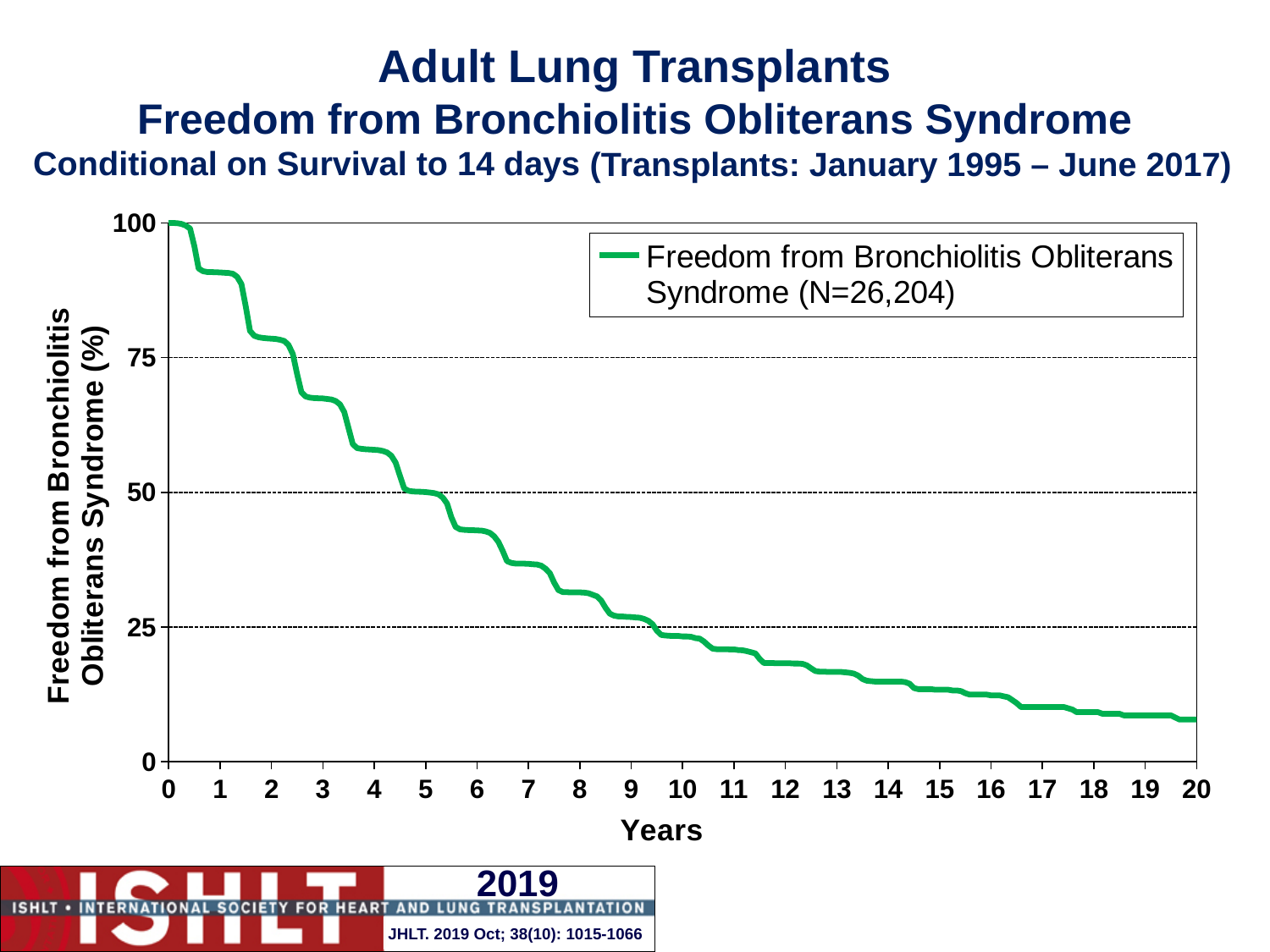
What is the value of freedom from Bronchiolitis Obliterans Syndrome at year 0? 100 Does the freedom from Bronchiolitis Obliterans Syndrome rise or fall as years increase? fall How many series does the legend list? 1 Is the value for freedom from Bronchiolitis Obliterans Syndrome at year 1 greater or less than 75? greater What is the N value given in the legend entry? N=26,204 Is the value for freedom from Bronchiolitis Obliterans Syndrome at year 3 greater or less than 50? greater What is the label of the x axis? Years Which is larger, the value at year 2 or the value at year 12? year 2 Is the value for freedom from Bronchiolitis Obliterans Syndrome at year 20 greater or less than 25? less What kind of chart is shown on the slide? line chart